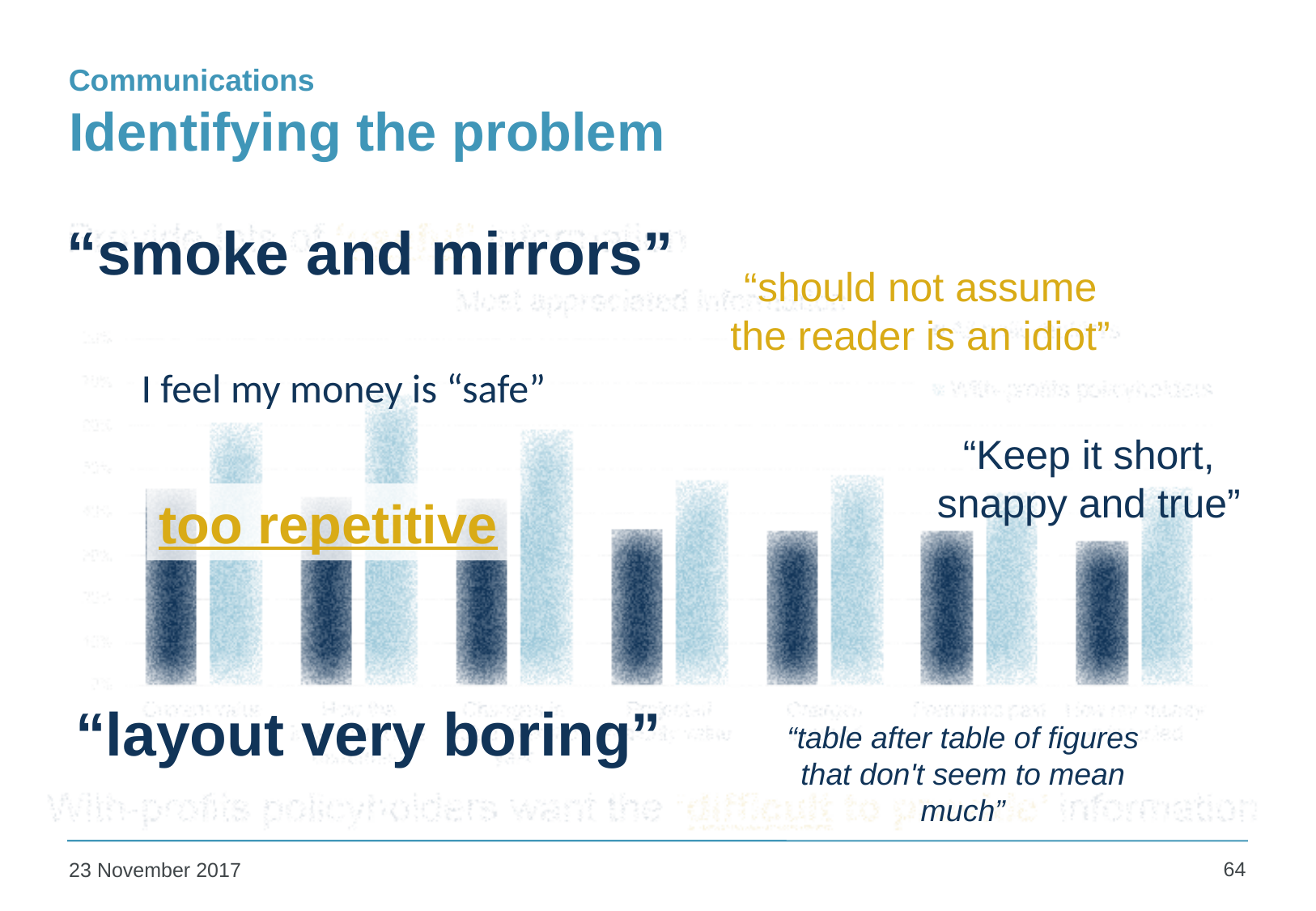
What two colours are used for the bars in the background chart? dark blue and light blue Are the bars in the background chart vertical or horizontal? vertical How many groups of bars are plotted in the background chart? 7 In the leftmost group of the background chart, which bar is taller, the dark blue or the light blue one? light blue In the rightmost group of the background chart, which bar is taller, the dark blue or the light blue one? light blue What kind of chart is shown in the background of the slide? bar chart How many bar series (colours) are plotted in the background chart? 2